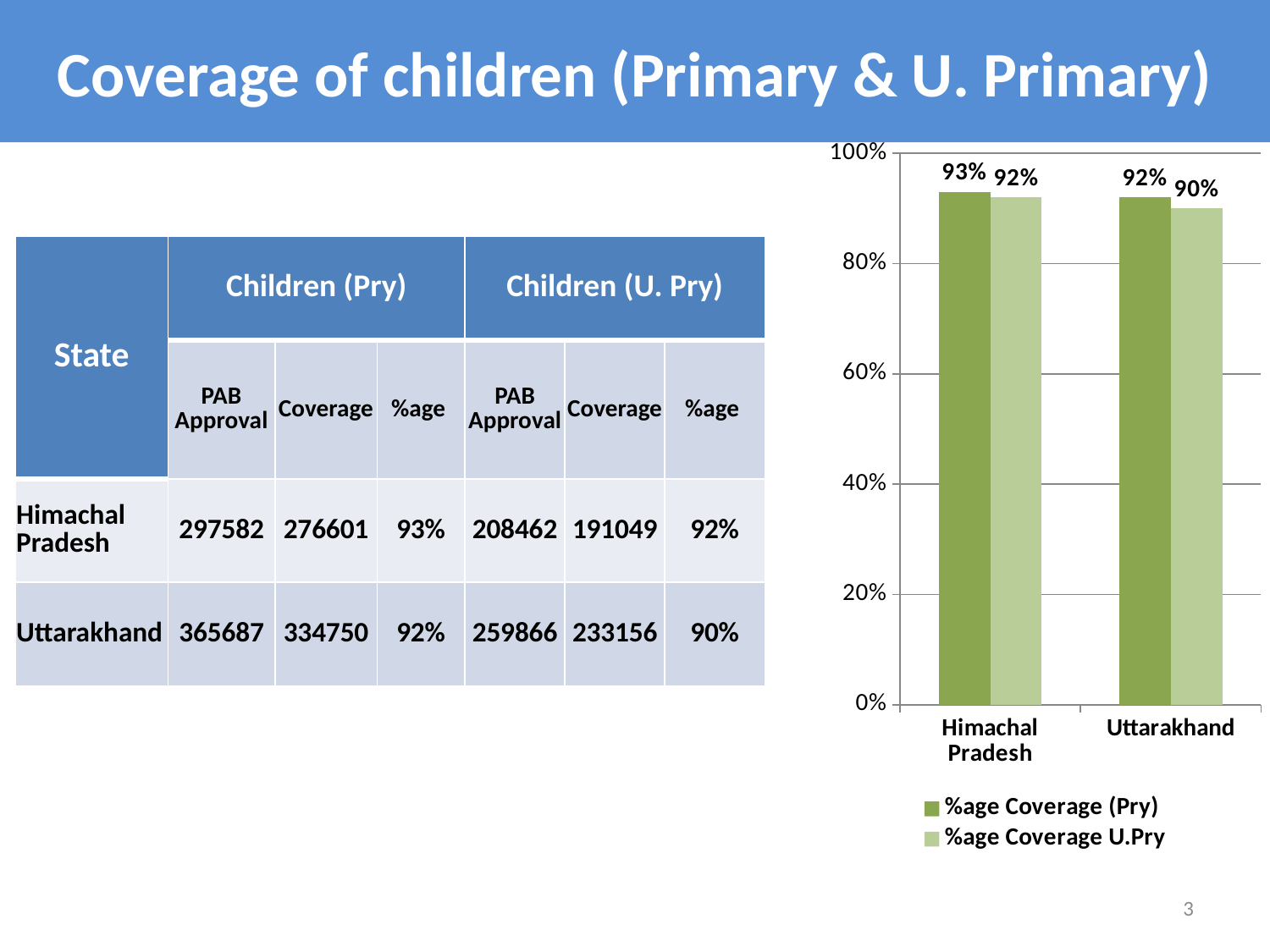
What is the %age Coverage (Pry) value for Uttarakhand in the chart? 92% How many states are shown on the x axis of the chart? 2 Is the %age Coverage U.Pry value for Uttarakhand greater or less than 80%? greater What is the %age Coverage U.Pry value for Uttarakhand in the chart? 90% What is the %age Coverage (Pry) value for Himachal Pradesh in the chart? 93% What is the %age Coverage U.Pry value for Himachal Pradesh in the chart? 92% What is the difference between the %age Coverage (Pry) values for Himachal Pradesh and Uttarakhand? 1% How many series does the chart legend list? 2 Which state has the lowest %age Coverage U.Pry in the chart? Uttarakhand What are the two series names listed in the chart legend? %age Coverage (Pry) and %age Coverage U.Pry What kind of chart is shown on the slide? bar chart What is the difference between the %age Coverage (Pry) and %age Coverage U.Pry values for Uttarakhand? 2%